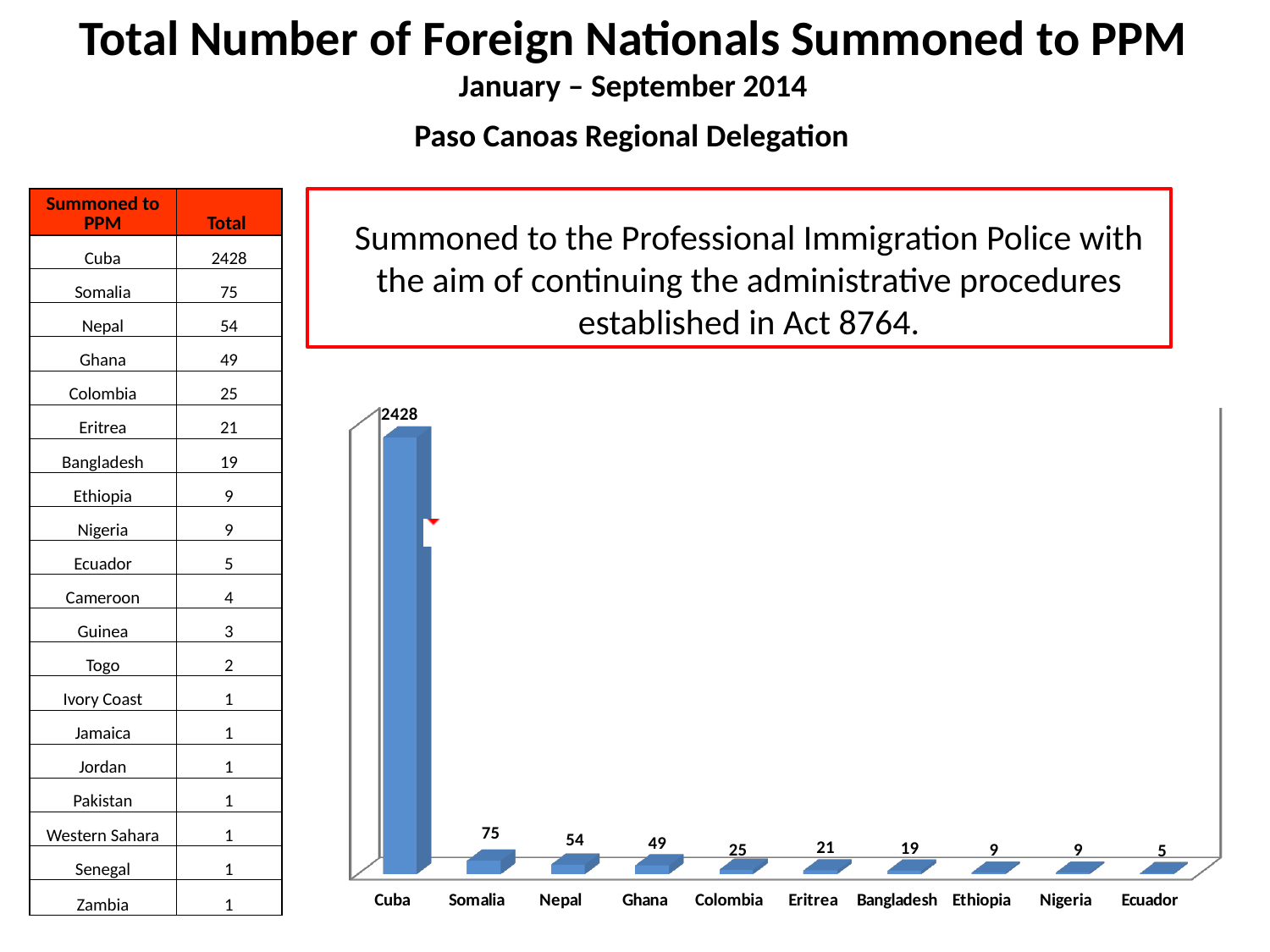
Which country has the highest bar in the chart? Cuba What is the difference between the values for Somalia and Nepal in the bar chart? 21 What is the value for Somalia in the bar chart? 75 Which country has the lowest bar in the chart? Ecuador Which is larger in the bar chart, the value for Colombia or the value for Eritrea? Colombia What is the value for Ghana in the bar chart? 49 What is the value for Bangladesh in the bar chart? 19 Do the values in the bar chart rise or fall from left to right along the x axis? fall How many countries are shown on the x axis of the bar chart? 10 What is the value for Cuba in the bar chart? 2428 What is the difference between the values for Ghana and Colombia in the bar chart? 24 What kind of chart is shown on the slide? bar chart